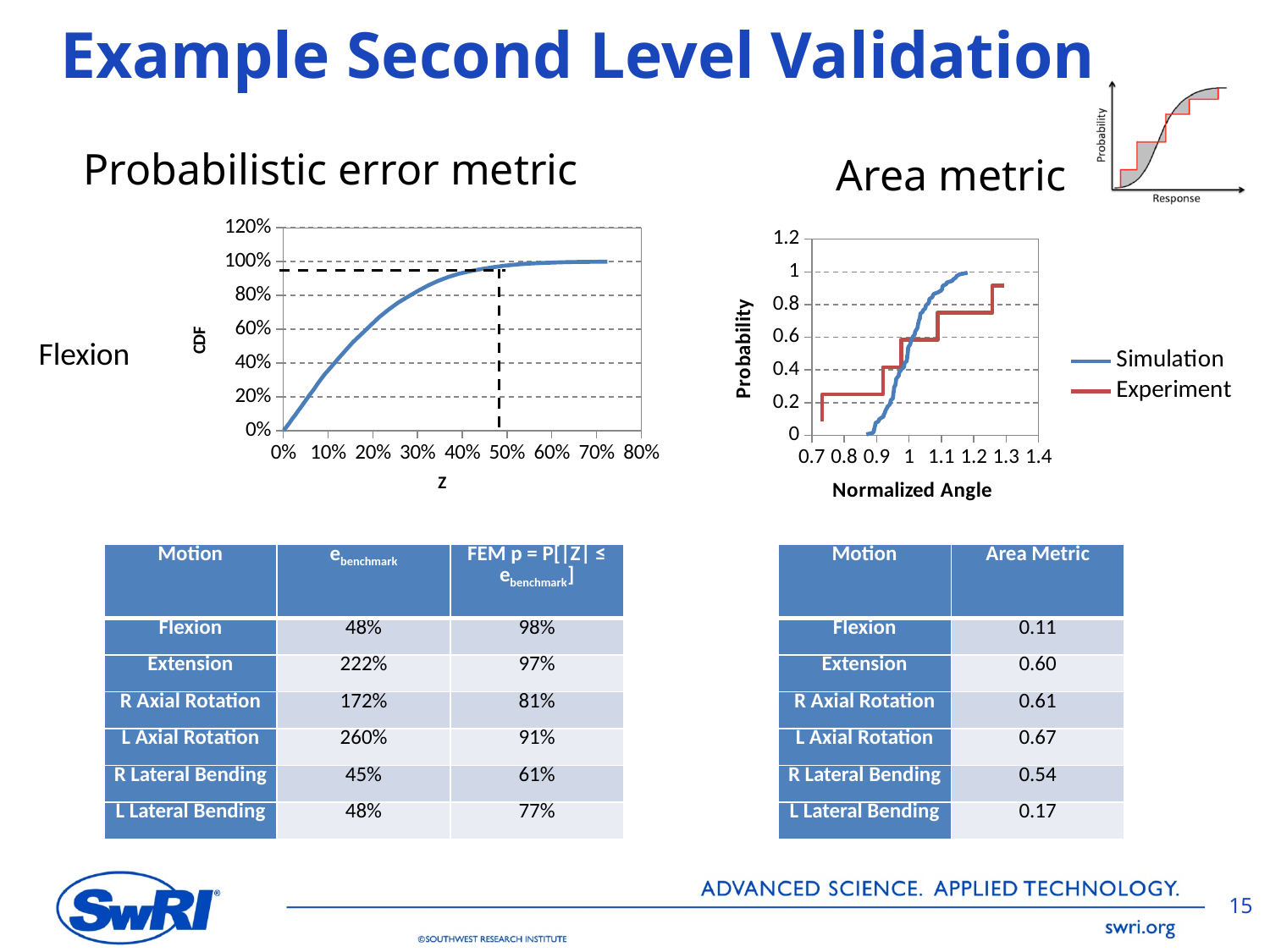
In the Probabilistic error metric chart, what is the label of the x axis? Z In the Area metric chart, what are the two series named in the legend? Simulation and Experiment In the Area metric chart, is the Simulation probability at a normalized angle of 1.0 greater or less than 0.8? less In the Probabilistic error metric chart, does the CDF rise or fall as Z increases? rise In the Probabilistic error metric chart, is the CDF value at Z = 40% greater or less than 80%? greater In the Area metric chart, is the Experiment probability at a normalized angle of 0.8 greater or less than 0.4? less What kind of chart is the Area metric chart on the right? line chart In the Area metric chart, how many series does the legend list? 2 What kind of chart is the Probabilistic error metric chart on the left? line chart In the Area metric chart, does the Simulation probability rise or fall as the normalized angle increases? rise